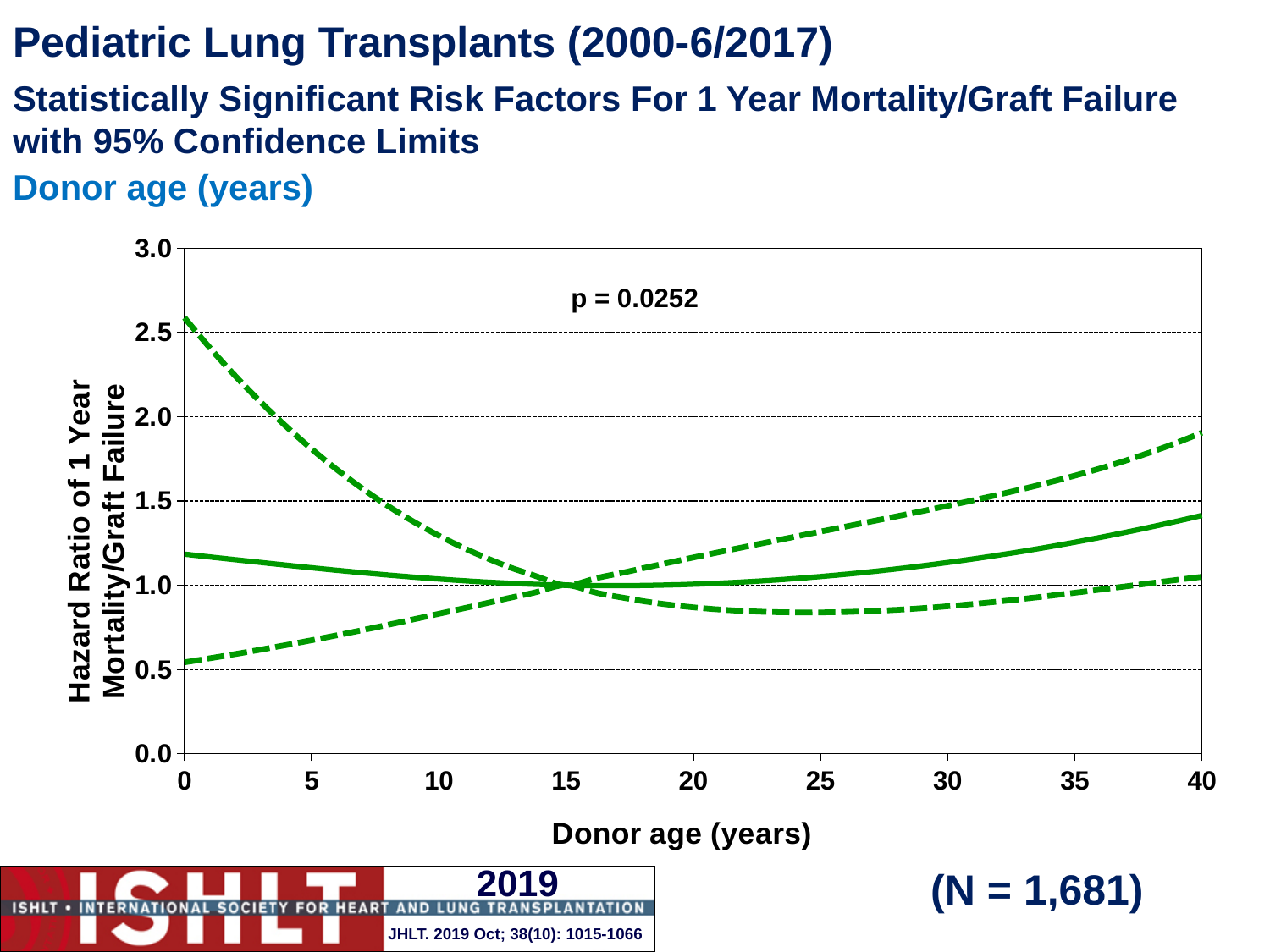
How many lines are plotted on the chart? 3 Is the value of the upper dashed line at donor age 0 greater or less than 2.0? greater What is the label of the x axis? Donor age (years) Does the solid line rise or fall as donor age increases from 15 to 40 years? rise At what donor age do the solid line and both dashed lines meet at a hazard ratio of 1.0? 15 What sample size (N) is printed on the slide? N = 1,681 Does the upper dashed line rise or fall as donor age increases from 0 to 15 years? fall What kind of chart is shown on the slide? line chart Is the value of the solid line at donor age 40 greater or less than 1.5? less Is the value of the solid line at donor age 0 greater or less than 1.0? greater What is the label of the y axis? Hazard Ratio of 1 Year Mortality/Graft Failure What is the p-value printed on the chart? p = 0.0252